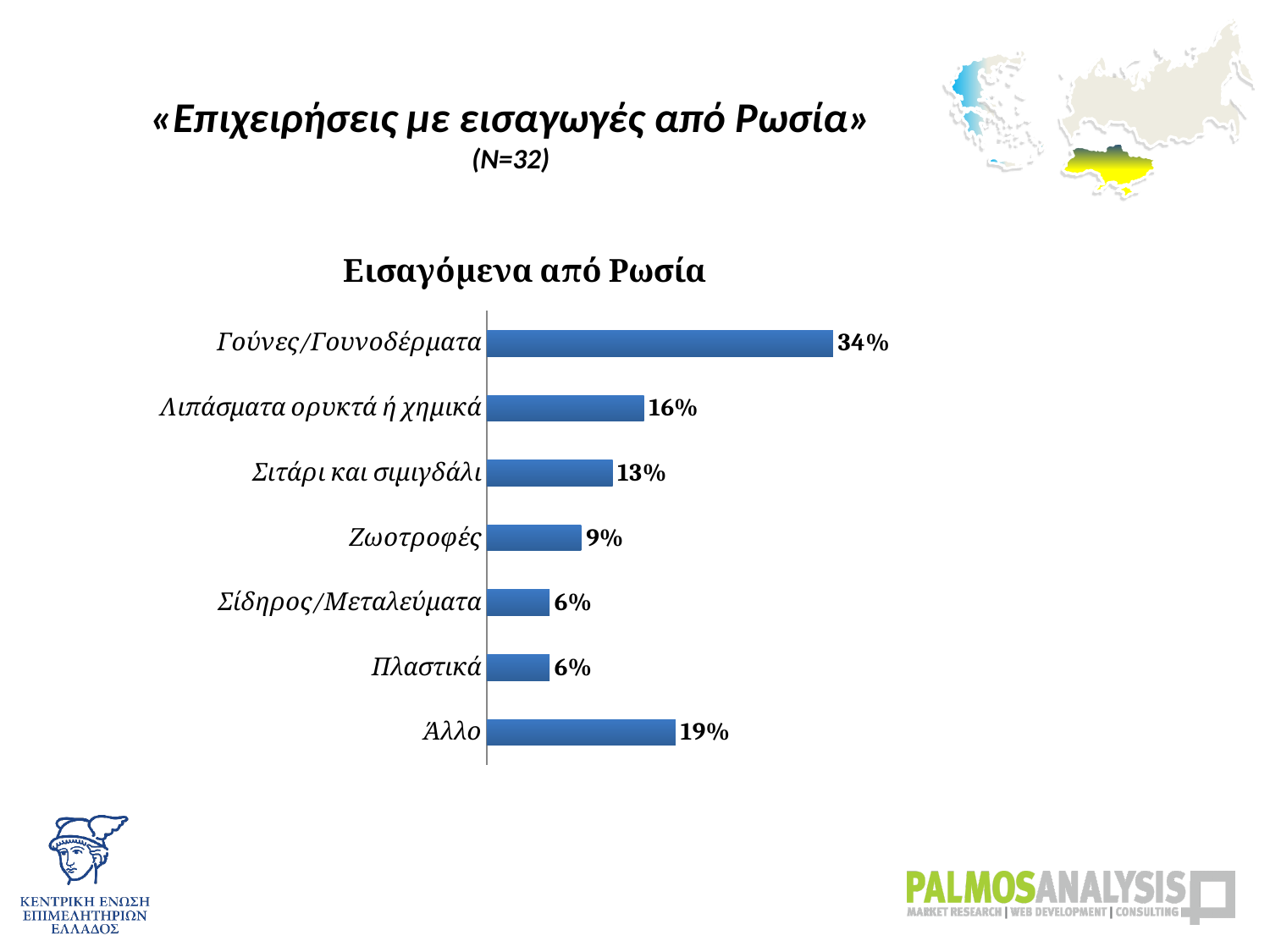
What is the title of the chart? Εισαγόμενα από Ρωσία What kind of chart is shown? Bar chart What is the difference between Γούνες/Γουνοδέρματα and Λιπάσματα ορυκτά ή χημικά? 18% How many categories are shown in the chart? 7 Which is larger, Σιτάρι και σιμιγδάλι or Ζωοτροφές? Σιτάρι και σιμιγδάλι What is the value for Σιτάρι και σιμιγδάλι? 13% Which is larger, Άλλο or Λιπάσματα ορυκτά ή χημικά? Άλλο Which category has the highest value? Γούνες/Γουνοδέρματα What is the value for Άλλο? 19% What is the difference between Άλλο and Ζωοτροφές? 10% What is the value for Γούνες/Γουνοδέρματα? 34% What is the value for Λιπάσματα ορυκτά ή χημικά? 16%